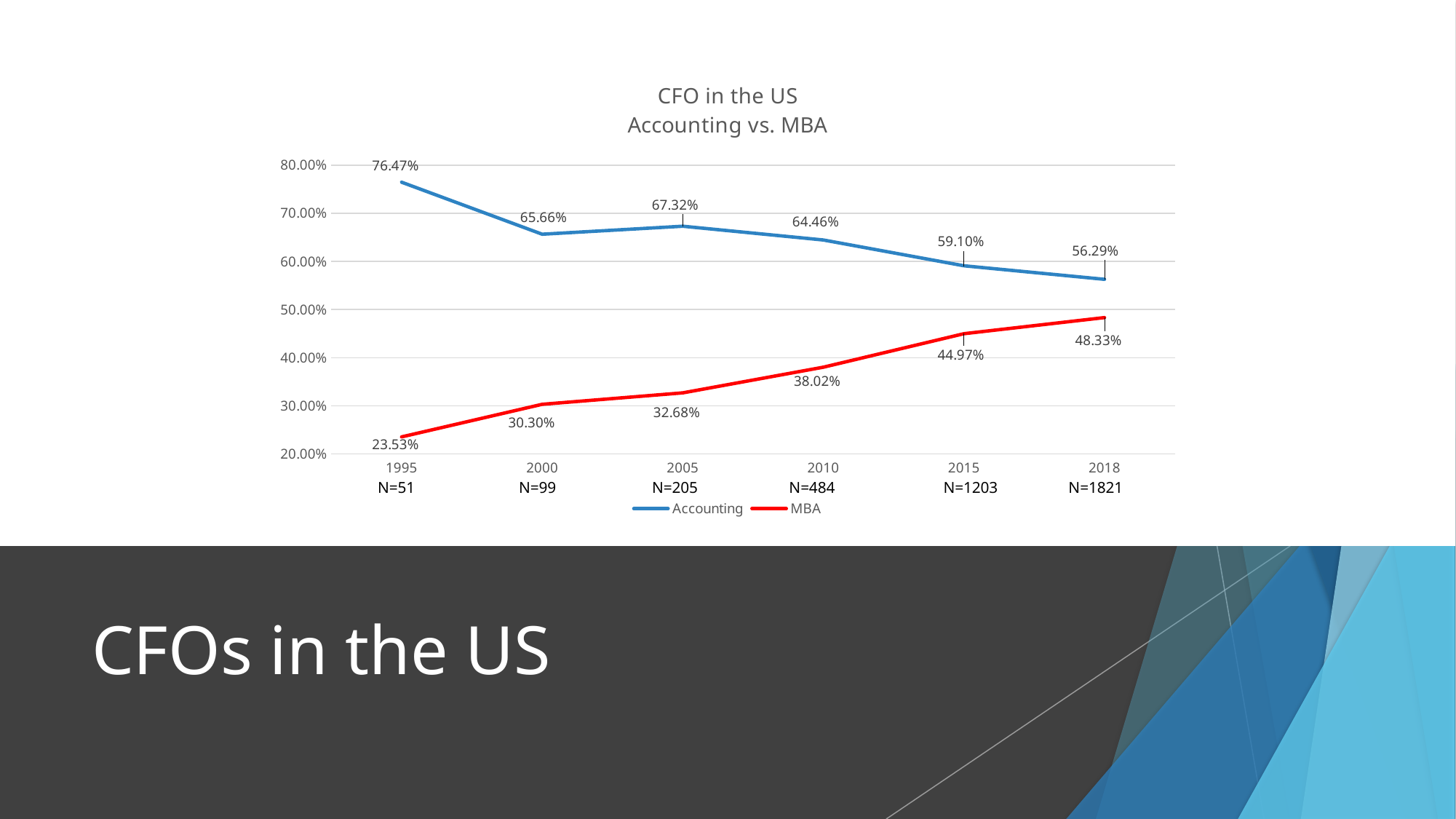
What is the MBA value for 2005? 32.68% How many series does the legend list? 2 What is the difference between the Accounting and MBA values in 2018? 7.96% In which year is the MBA series lowest? 1995 Does the MBA series rise or fall from 1995 to 2018? Rise How many years are plotted on the x axis? 6 What kind of chart is shown? Line chart What is the MBA value for 2018? 48.33% What is the Accounting value for 2010? 64.46% In which year is the Accounting series highest? 1995 Which is larger in 2015, the Accounting value or the MBA value? Accounting What is the Accounting value for 1995? 76.47%